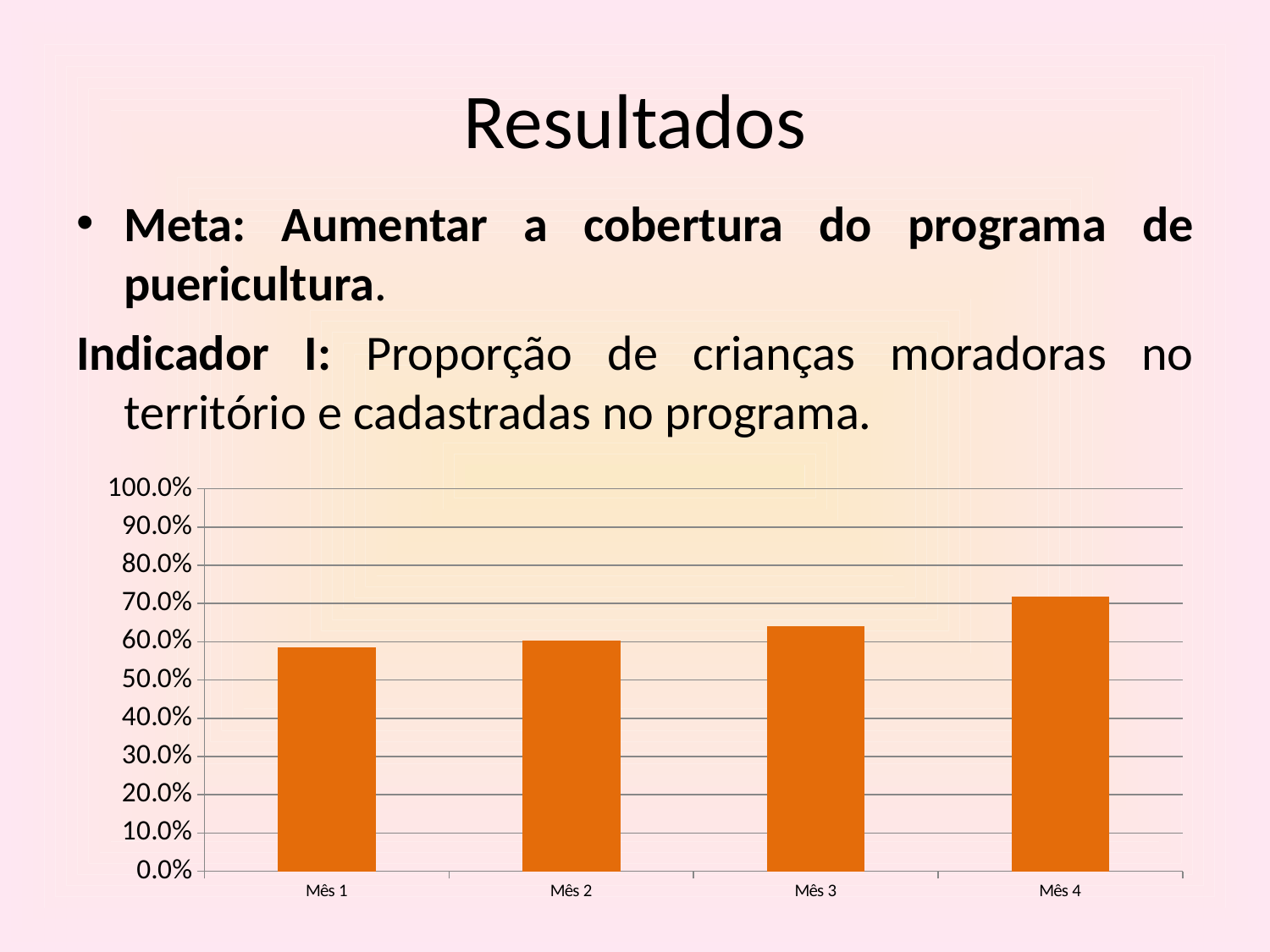
What is the maximum value shown on the chart's vertical axis? 100.0% Which is larger, the value for Mês 4 or the value for Mês 2? Mês 4 Which month has the highest bar on the chart? Mês 4 Which is larger, the value for Mês 3 or the value for Mês 1? Mês 3 Which month has the lowest bar on the chart? Mês 1 Is the value for Mês 3 greater or less than 70.0%? less Is the value for Mês 4 greater or less than 80.0%? less How many categories (months) are plotted on the chart? 4 What kind of chart is shown on the slide? bar chart Is the value for Mês 1 greater or less than 50.0%? greater Do the values rise or fall from Mês 1 to Mês 4? rise